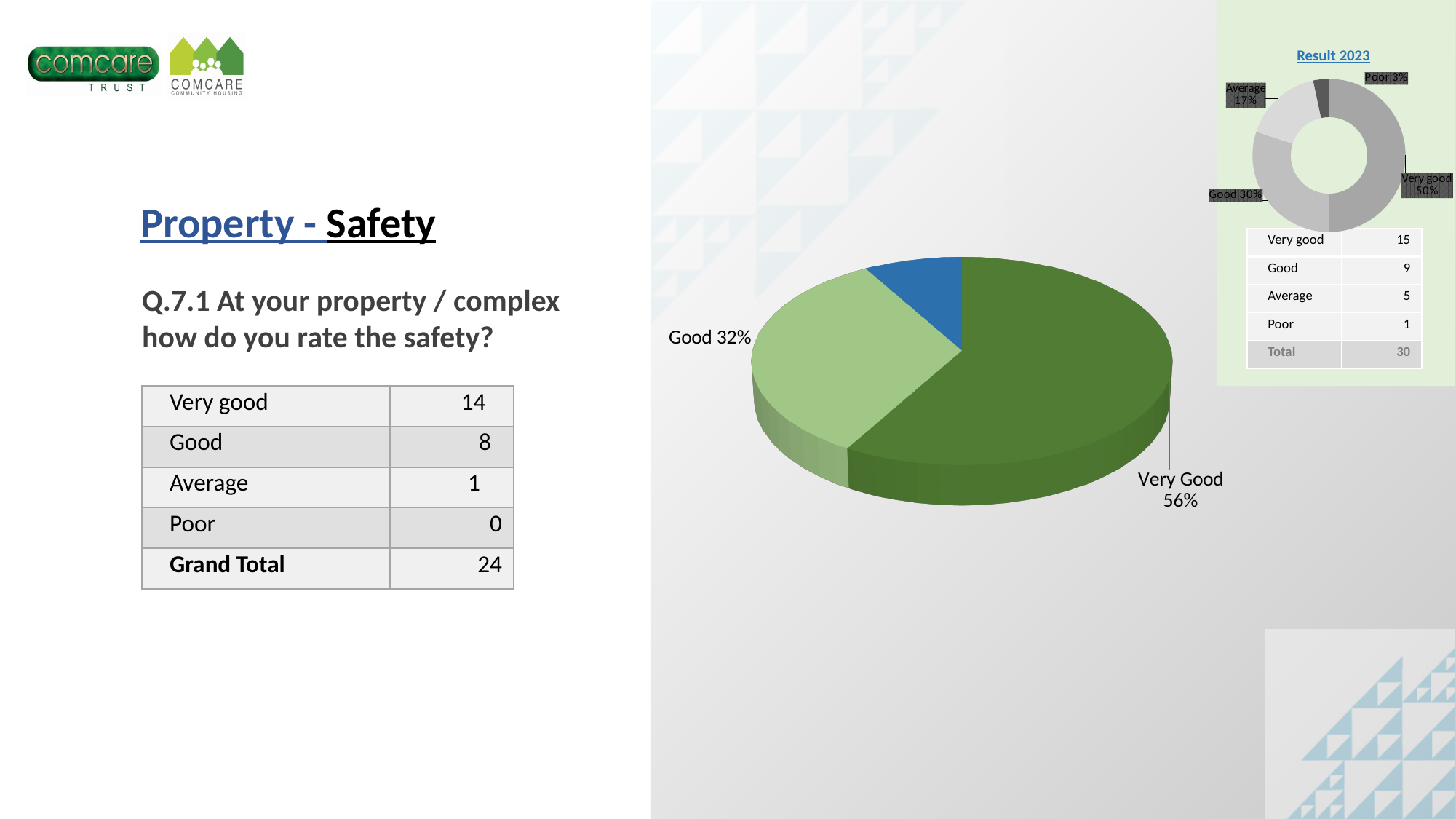
In the large pie chart, which is larger, the Very Good slice or the Good slice? Very Good In the Result 2023 donut chart, what share is labelled for Average? 17% In the large pie chart, what is the difference between the Very Good and Good shares? 24% In the large pie chart, which labelled slice is the largest? Very Good In the large pie chart, what share is labelled for Good? 32% In the Result 2023 donut chart, what share is labelled for Very good? 50% In the Result 2023 donut chart, which category has the smallest share? Poor In the Result 2023 donut chart, what is the difference between the Good and Average shares? 13% What type of chart is the large chart in the centre of the slide? Pie chart In the large pie chart, what share is labelled for Very Good? 56% What is the title of the small donut chart in the top right of the slide? Result 2023 How many slices does the large pie chart have? 3